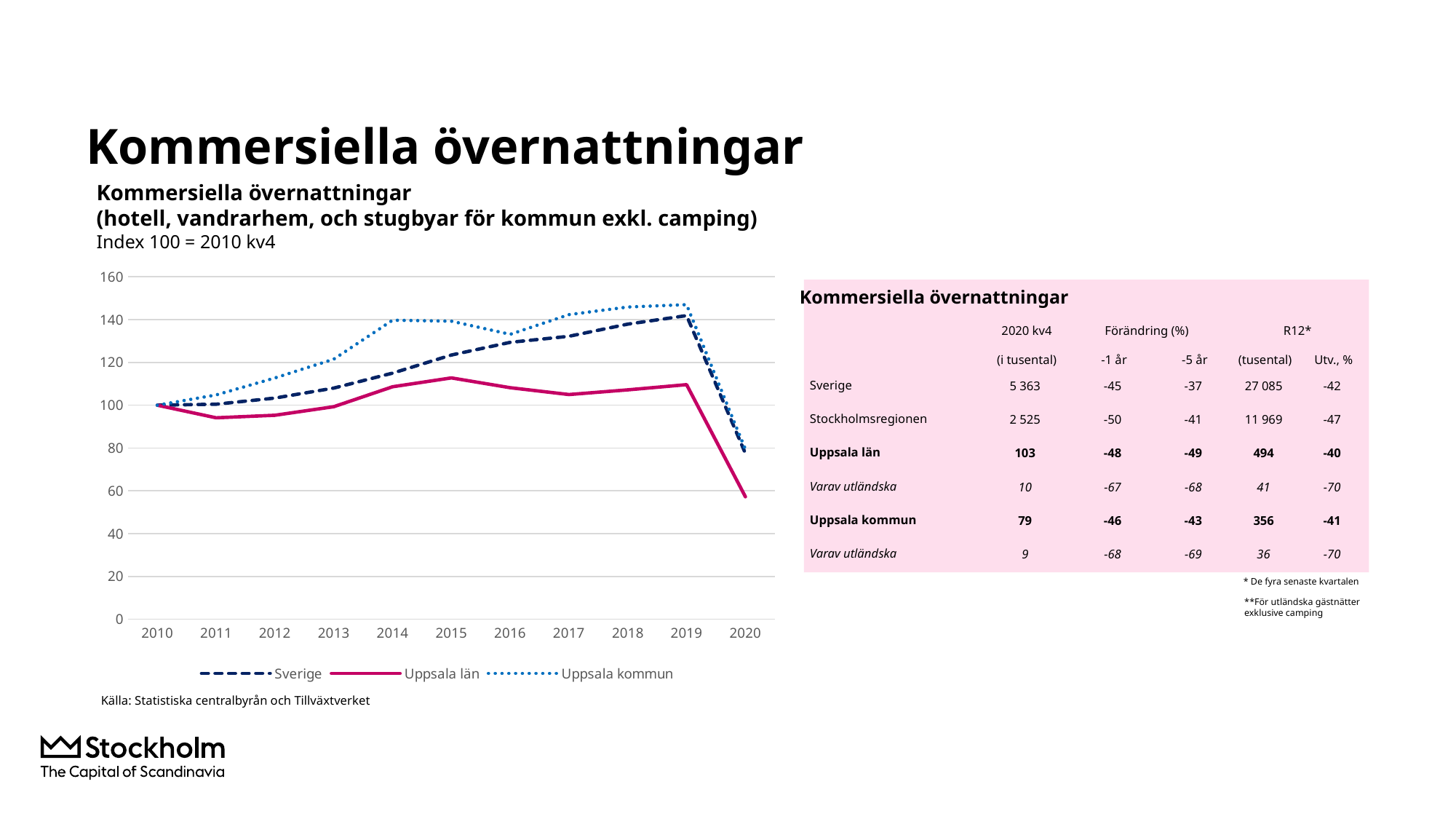
How many series does the chart legend list? 3 Which series has the highest value in 2019? Uppsala kommun Which is larger in 2016, the value for Uppsala kommun or the value for Uppsala län? Uppsala kommun Is the value for Uppsala kommun in 2019 greater or less than 140? greater What is the index value for Sverige in 2010? 100 Which series has the lowest value in 2020? Uppsala län What kind of chart is shown on the slide? line chart Which series is drawn with a solid line in the chart? Uppsala län Is the value for Uppsala län in 2011 greater or less than 100? less Is the value for Uppsala län in 2020 greater or less than 80? less Does the Sverige series rise or fall from 2010 to 2019? rise How many years are shown on the x axis of the chart? 11